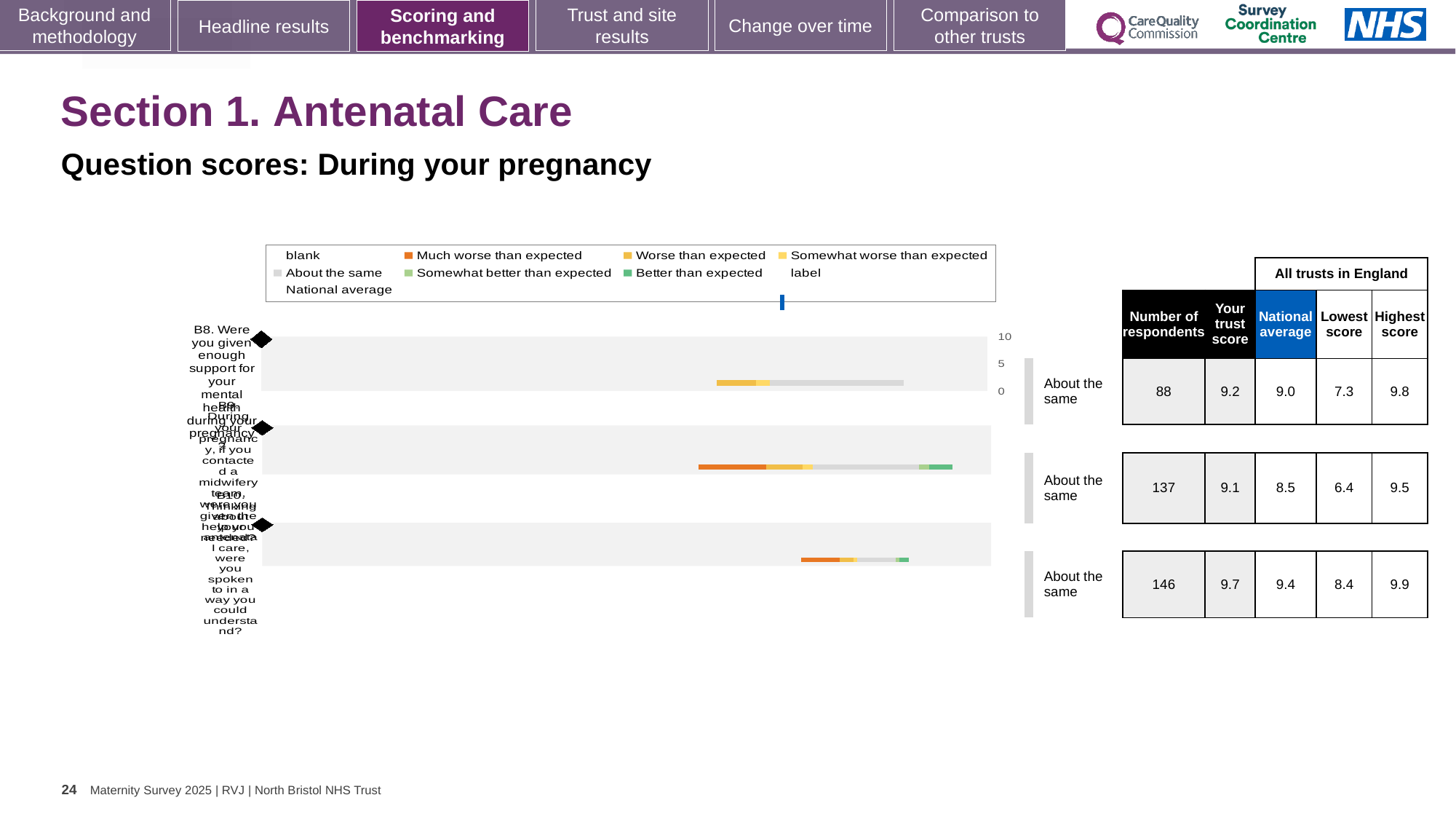
What is 'Your trust score' for the first row (B8)? 9.2 Which row has the highest 'Your trust score'? the third row (9.7) What is the national average for the second row of the chart? 8.5 What is the highest score among all trusts in England for the third row? 9.9 For the second row, which is larger: the trust score or the national average? the trust score (9.1) What kind of chart is shown on the slide? bar chart What is the difference between the trust score and the national average for the first row (B8)? 0.2 What benchmark category is shown for the first row (B8)? About the same How many respondents are listed for the first row (B8, support for your mental health during pregnancy)? 88 In the chart legend, which category is shown in grey? About the same How many question rows (bars) are plotted in the chart? 3 In the chart legend, what colour represents 'Much worse than expected'? orange